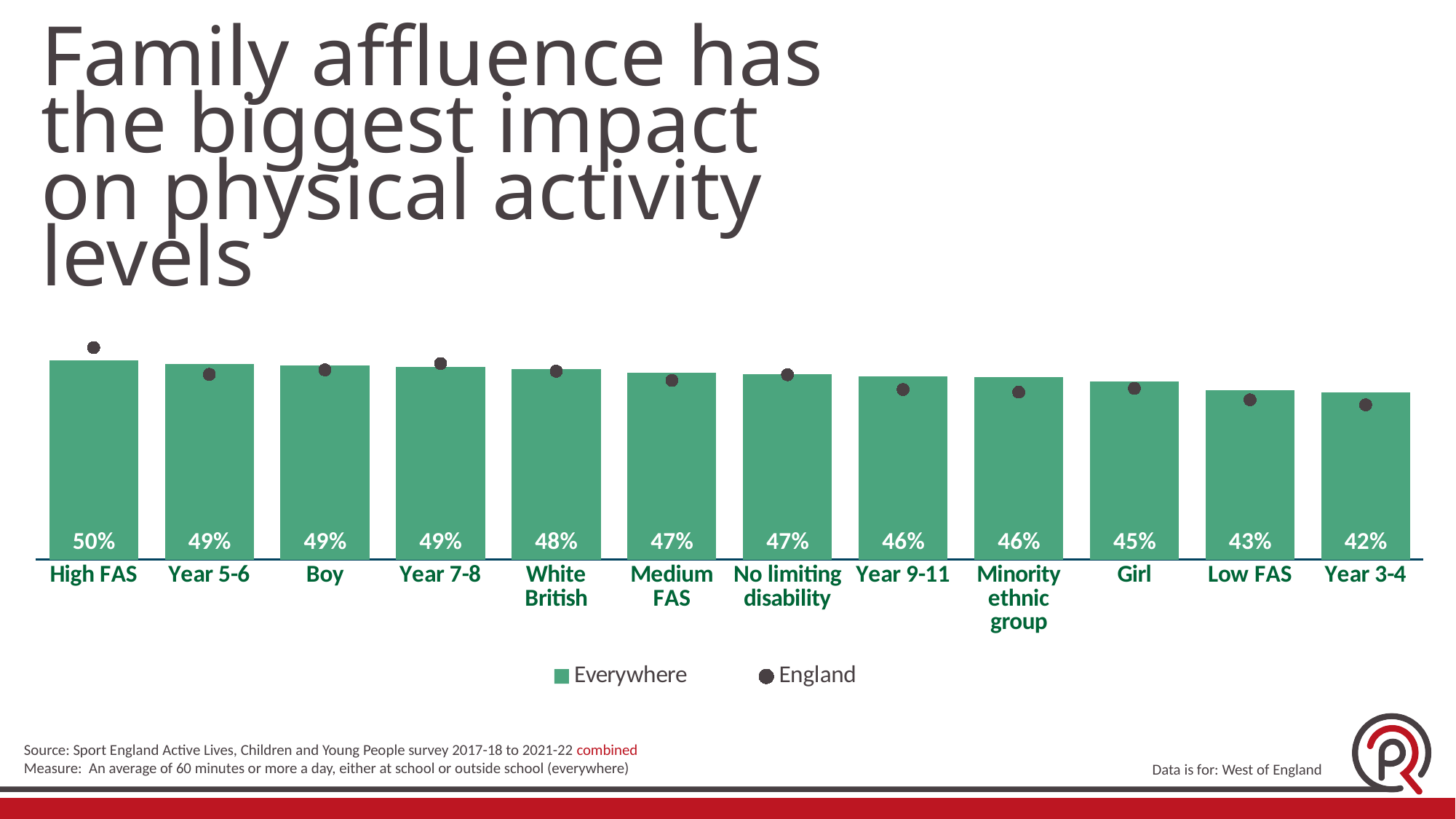
What is the Everywhere value for Year 3-4? 42% What is the difference between the Everywhere values for High FAS and Low FAS? 7 percentage points Which category has the highest Everywhere value? High FAS What is the Everywhere value for High FAS? 50% How many categories are shown on the x axis? 12 Which category has the lowest Everywhere value? Year 3-4 Which has the larger Everywhere value, Boy or Girl? Boy Do the Everywhere values rise or fall from left to right across the categories? Fall How many series does the legend list? 2 What is the Everywhere value for Girl? 45% What kind of chart is shown on the slide? Bar chart What is the Everywhere value for Medium FAS? 47%